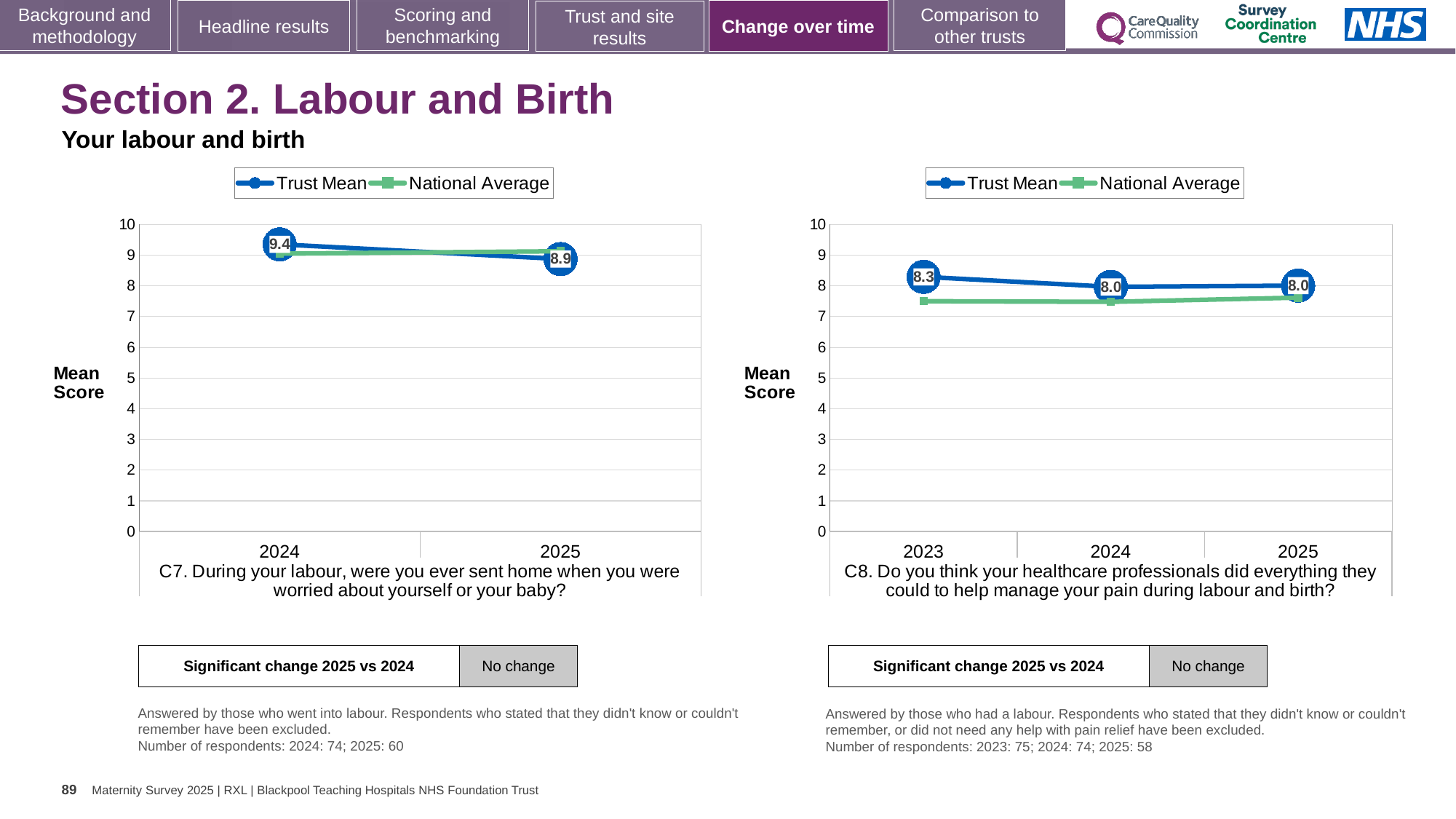
In the right chart (C8), how many years are shown on the x axis? 3 How many series does the legend of the left chart (C7) list? 2 In the left chart (C7), what is the Trust Mean for 2024? 9.4 In the right chart (C8), what is the Trust Mean for 2025? 8.0 In the right chart (C8), what is the difference between the Trust Mean in 2023 and in 2024? 0.3 In the right chart (C8), what is the Trust Mean for 2023? 8.3 In the left chart (C7), what is the Trust Mean for 2025? 8.9 In the left chart (C7), by how much did the Trust Mean fall from 2024 to 2025? 0.5 In the right chart (C8), is the National Average for 2023 greater or less than 8? less In the right chart (C8), does the Trust Mean rise or fall from 2023 to 2025? fall In the right chart (C8), which year has the highest Trust Mean? 2023 What kind of chart is the right chart (C8)? line chart